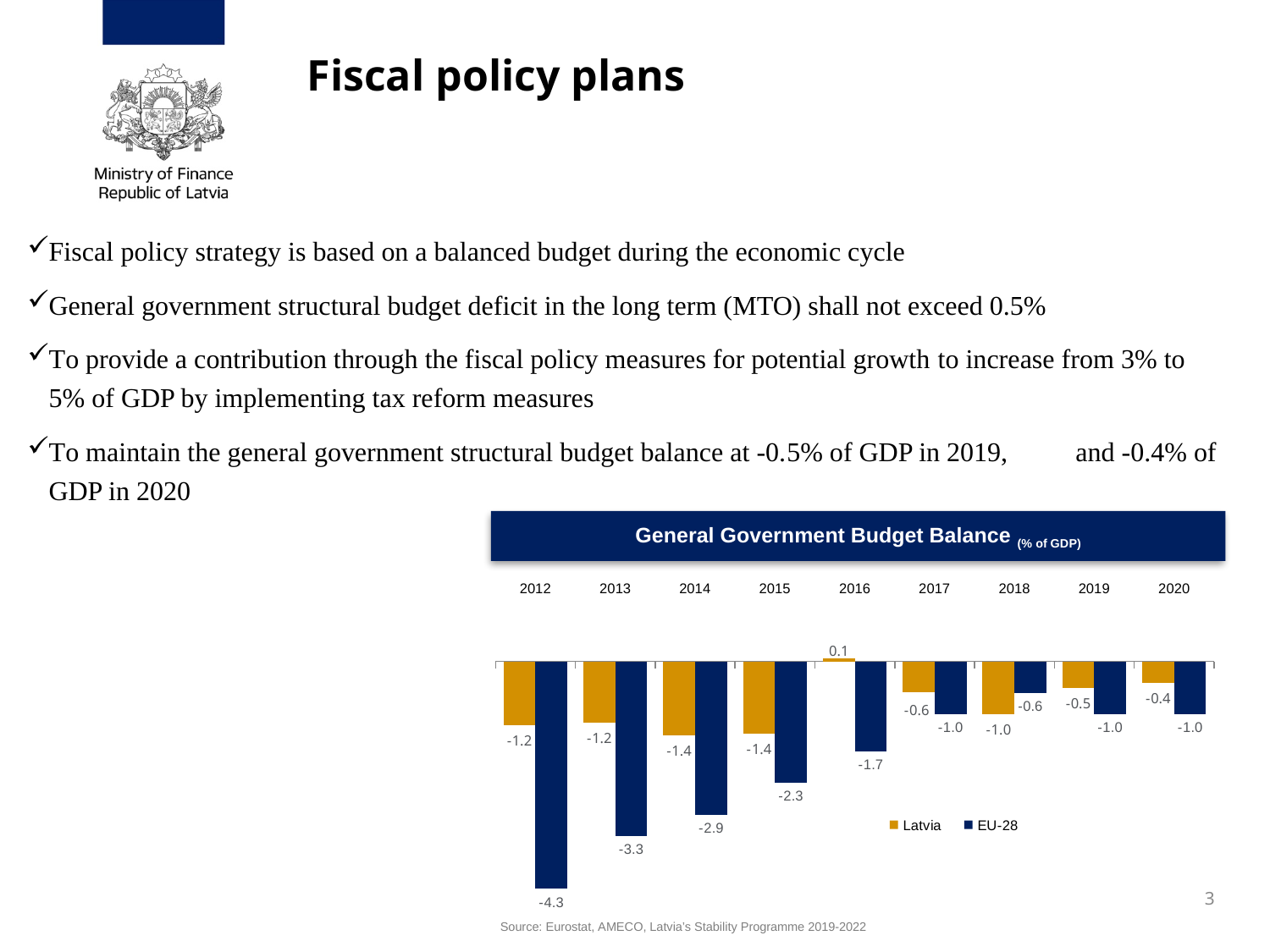
Which is larger in 2018: the Latvia value or the EU-28 value? EU-28 What is the EU-28 value for 2012 in the General Government Budget Balance chart? -4.3 How many series does the legend of the General Government Budget Balance chart list? 2 In which year is the Latvia budget balance highest in the chart? 2016 What is the difference between the EU-28 and Latvia values for 2013 in the chart? 2.1 What is the Latvia value for 2016 in the General Government Budget Balance chart? 0.1 What is the Latvia value for 2020 in the General Government Budget Balance chart? -0.4 What type of chart is the General Government Budget Balance chart? Bar chart How many years are shown on the x axis of the General Government Budget Balance chart? 9 What is the EU-28 value for 2015 in the General Government Budget Balance chart? -2.3 In which year is the EU-28 budget balance lowest in the chart? 2012 Does the EU-28 budget balance rise or fall from 2012 to 2018 in the chart? Rise